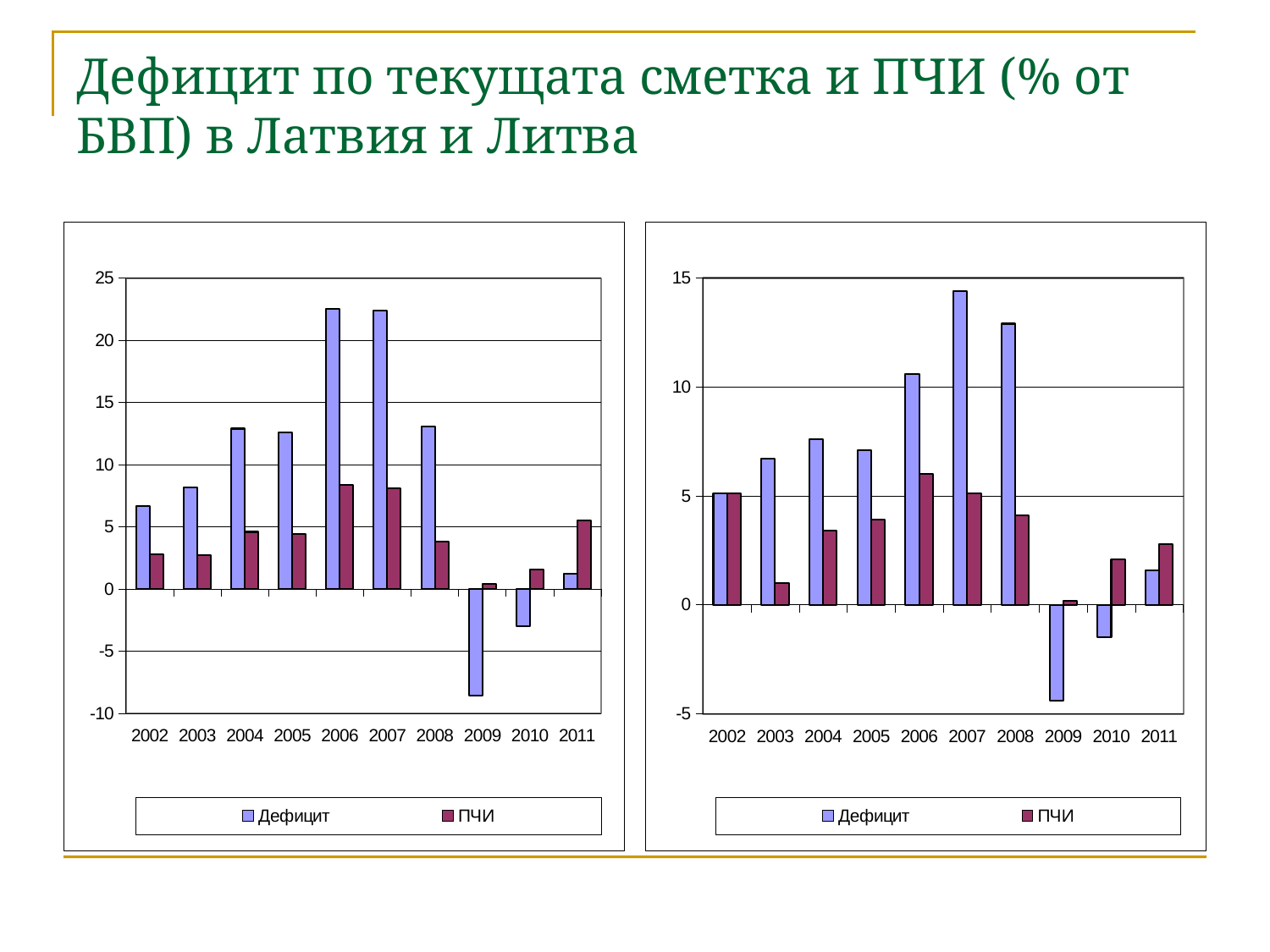
In the left chart, is the value for ПЧИ in 2011 greater or less than 5? greater In the left chart, how many series does the legend list? 2 In the right chart, which year has the highest value for Дефицит? 2007 In the left chart, which is larger in 2011, Дефицит or ПЧИ? ПЧИ In the right chart, which is larger in 2003, Дефицит or ПЧИ? Дефицит In the right chart, what are the two legend entries? Дефицит and ПЧИ In the right chart, which year has the highest value for ПЧИ? 2006 In the left chart, what kind of chart is shown? bar chart In the right chart, is the value for Дефицит in 2008 greater or less than 10? greater In the left chart, is the value for Дефицит in 2006 greater or less than 20? greater In the right chart, how many years are shown on the x axis? 10 In the left chart, which year has the lowest value for Дефицит? 2009